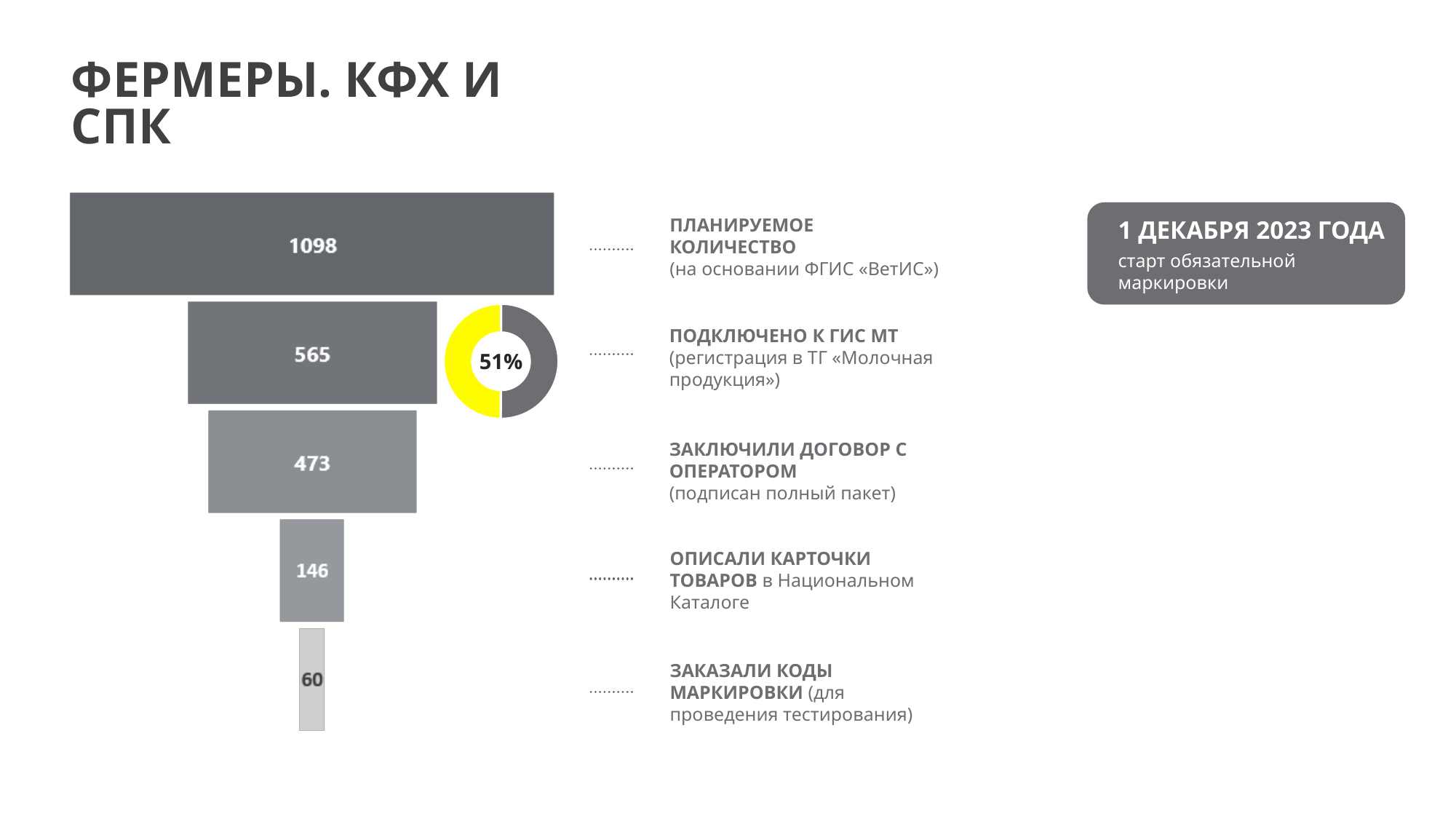
In the funnel chart, what is the value for «Заказали коды маркировки»? 60 What kind of chart is the main chart on the left of the slide? Funnel chart How many stages does the funnel chart show? 5 In the funnel chart, what is the difference between «Заключили договор с оператором» and «Описали карточки товаров»? 327 In the funnel chart, what is the value for «Подключено к ГИС МТ»? 565 In the funnel chart, which stage has the highest value? Планируемое количество In the funnel chart, which stage has the lowest value? Заказали коды маркировки In the funnel chart, what is the value for «Заключили договор с оператором»? 473 In the funnel chart, what is the difference between «Планируемое количество» and «Подключено к ГИС МТ»? 533 In the funnel chart, what is the value for «Описали карточки товаров»? 146 In the funnel chart, what is the value for «Планируемое количество»? 1098 What percentage does the small donut chart next to the «Подключено к ГИС МТ» stage show? 51%